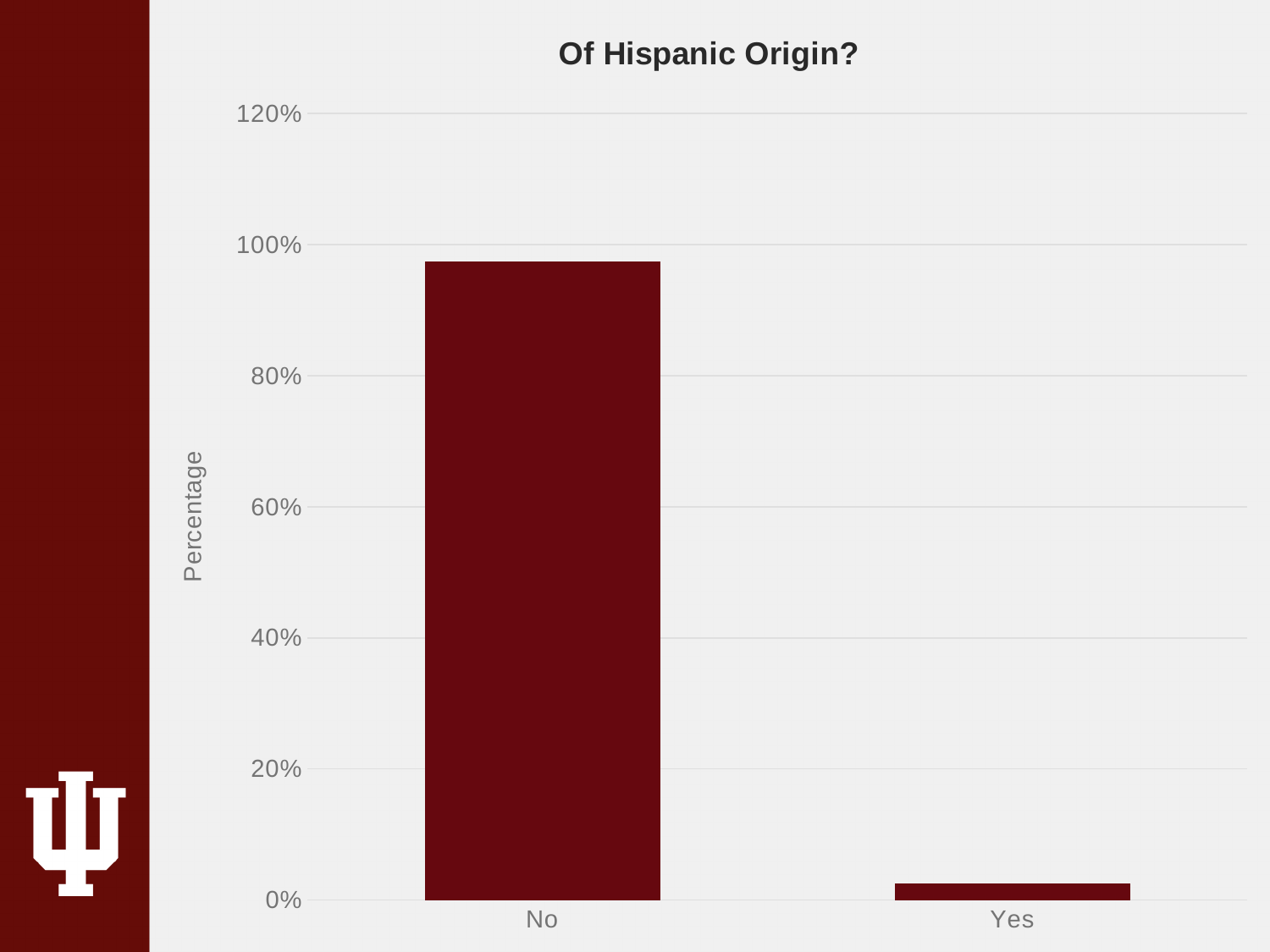
Which category has the highest value? No Is the value for Yes greater or less than 20%? less What is the label of the y axis? Percentage What type of chart is shown on the slide? bar chart How many categories are shown on the x axis? 2 What is the title of the chart? Of Hispanic Origin? Which category has the lowest value? Yes Is the value for No greater or less than 100%? less Do the values rise or fall from No to Yes along the x axis? fall Which is larger, the value for No or the value for Yes? No Is the value for No greater or less than 80%? greater